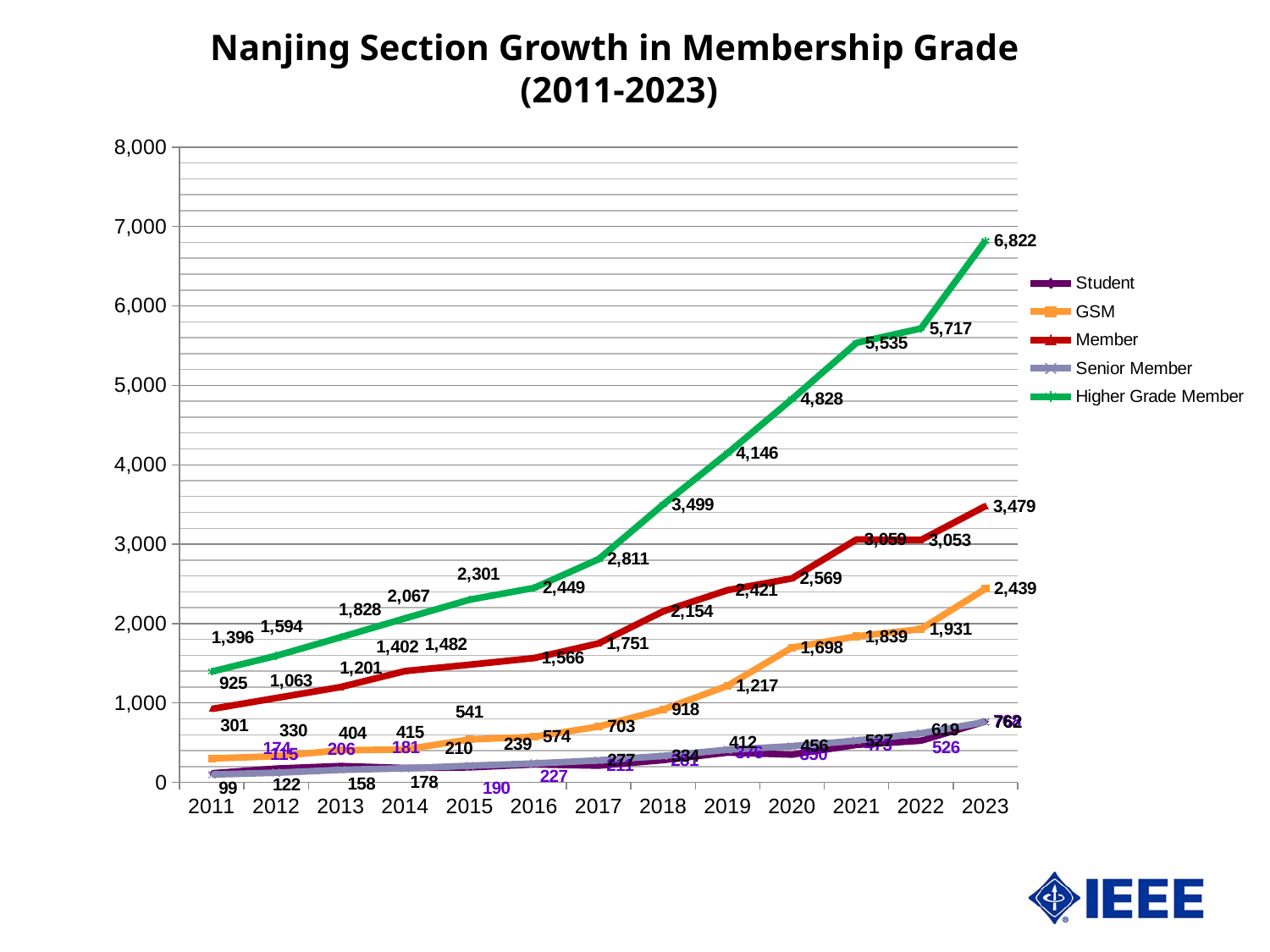
By how much did the Higher Grade Member value increase from 2011 to 2023? 5,426 What is the GSM value for 2019? 1,217 How many series does the legend list? 5 Which is larger in 2023, the Member value or the GSM value? Member Which series has the highest value in 2023? Higher Grade Member What is the Senior Member value for 2022? 619 What is the Member value for 2011? 925 What is the difference between the Member values for 2023 and 2022? 426 What is the Student value for 2011? 115 How many years are plotted on the x axis? 13 What is the Higher Grade Member value for 2023? 6,822 What kind of chart is shown on the slide? Line chart